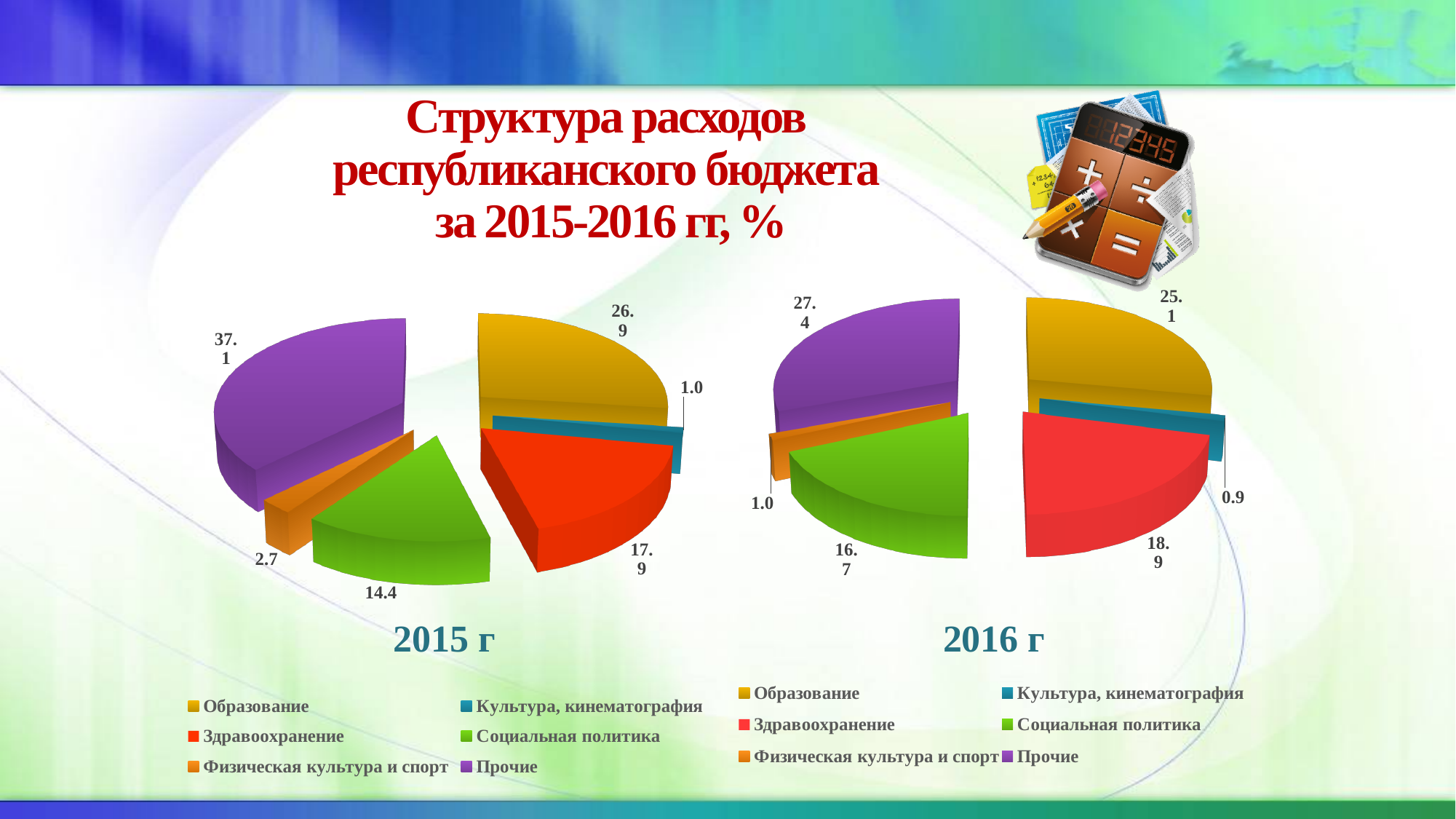
What type of chart is used for 2015 г? Pie chart In the 2015 г pie chart, what is the value for Образование? 26.9 In the 2015 г pie chart, which category has the largest share? Прочие In the 2016 г pie chart, what is the value for Здравоохранение? 18.9 In the 2015 г pie chart, what is the difference between Прочие and Образование? 10.2 In the 2015 г pie chart, what is the value for Социальная политика? 14.4 How many categories does the legend of the 2016 г pie chart list? 6 In the 2016 г pie chart, what colour represents Социальная политика? Green In the 2015 г pie chart, what is the value for Физическая культура и спорт? 2.7 In the 2016 г pie chart, what is the value for Прочие? 27.4 In the 2016 г pie chart, which is larger: Образование or Здравоохранение? Образование In the 2016 г pie chart, which category has the smallest share? Культура, кинематография